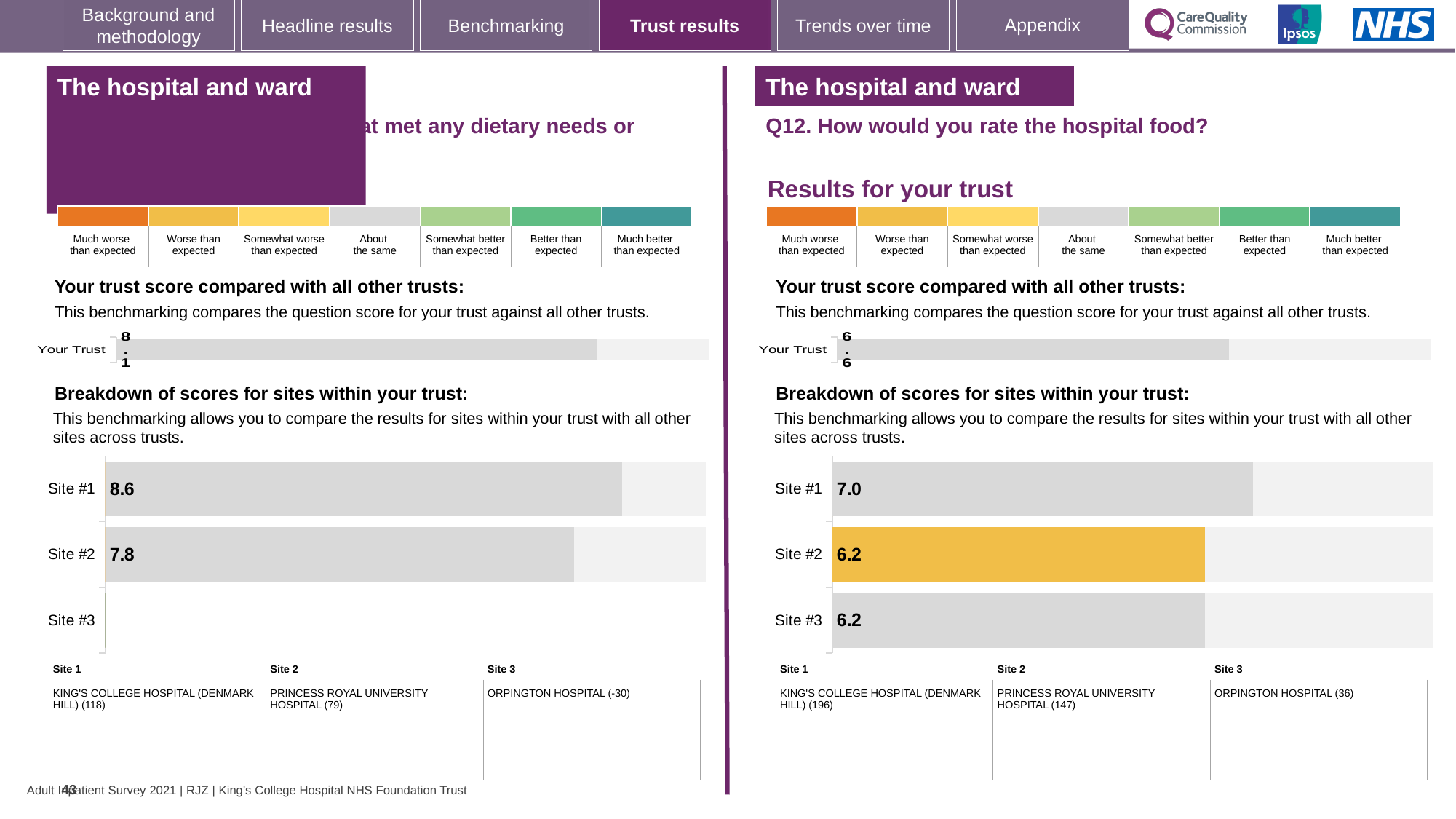
On the right-hand chart for Q12 (How would you rate the hospital food?), what is the score for Site #1? 7.0 On the left-hand site breakdown chart, what is the score for Site #2? 7.8 On the right-hand chart for Q12 (How would you rate the hospital food?), what is the 'Your Trust' score? 6.6 On the left-hand chart, what is the 'Your Trust' score? 8.1 On the left-hand site breakdown chart, what is the score for Site #1? 8.6 What kind of chart is used for the site breakdown on the right-hand side of the slide? Bar chart On the right-hand chart for Q12 (How would you rate the hospital food?), what is the score for Site #2? 6.2 On the right-hand chart for Q12 (How would you rate the hospital food?), what is the difference between the Site #1 score and the Site #2 score? 0.8 On the right-hand chart for Q12 (How would you rate the hospital food?), which site has the highest score? Site #1 On the left-hand site breakdown chart, which is larger, the score for Site #1 or Site #2? Site #1 On the right-hand chart for Q12 (How would you rate the hospital food?), which site's bar is coloured yellow rather than grey? Site #2 On the right-hand chart for Q12 (How would you rate the hospital food?), how many sites are listed in the site breakdown? 3